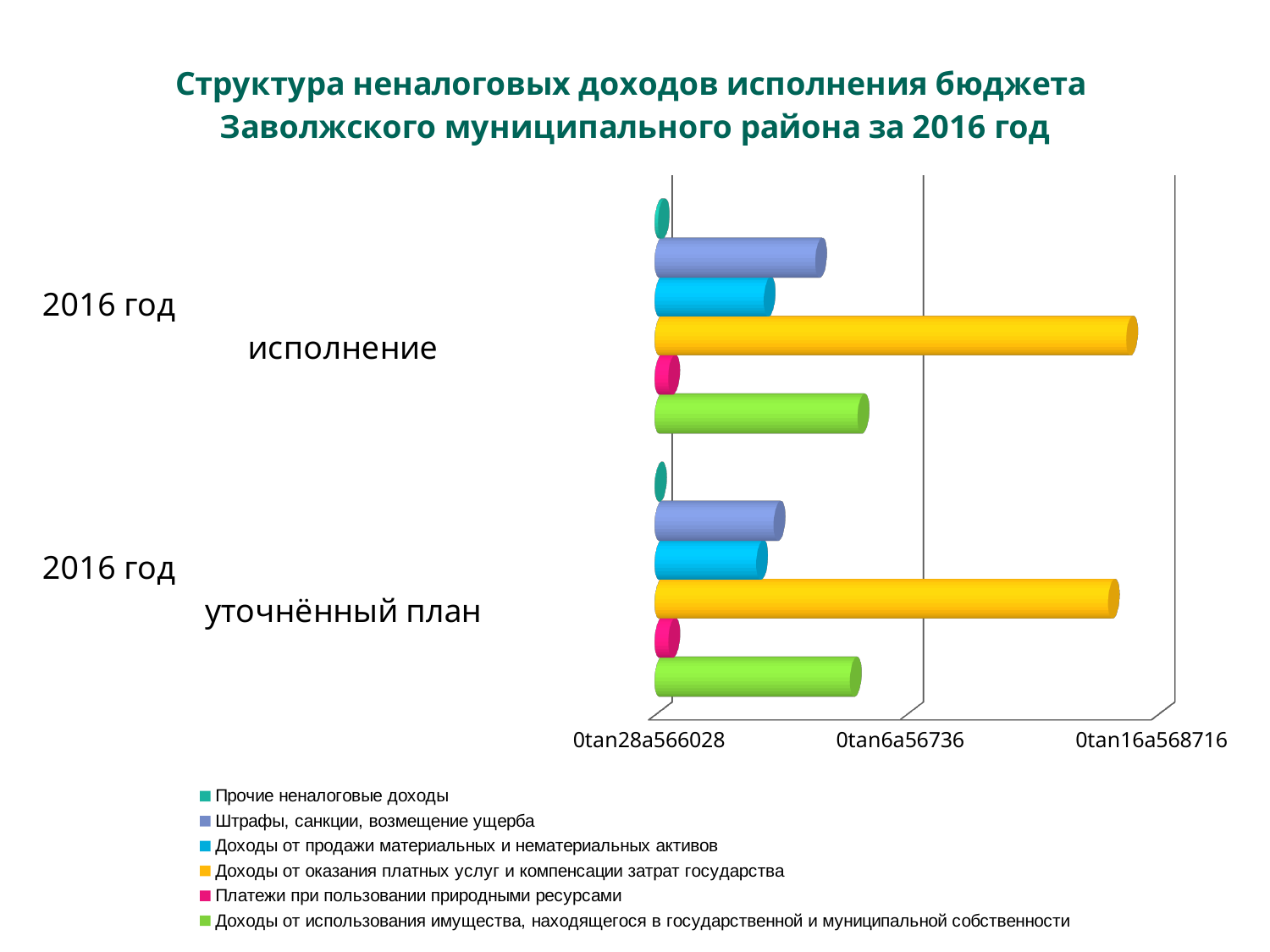
What kind of chart is shown on the slide? bar chart What is the title of the chart? Структура неналоговых доходов исполнения бюджета Заволжского муниципального района за 2016 год How many categories (groups of bars) does the chart show? 2 In the "2016 год уточнённый план" group, which is larger: "Доходы от использования имущества, находящегося в государственной и муниципальной собственности" or "Штрафы, санкции, возмещение ущерба"? Доходы от использования имущества, находящегося в государственной и муниципальной собственности Which colour represents "Платежи при пользовании природными ресурсами" in the legend? pink Which series has the shortest bar in the "2016 год уточнённый план" group? Прочие неналоговые доходы Which series has the longest bar in the "2016 год исполнение" group? Доходы от оказания платных услуг и компенсации затрат государства How many series does the legend list? 6 In the "2016 год исполнение" group, which is larger: "Доходы от использования имущества, находящегося в государственной и муниципальной собственности" or "Платежи при пользовании природными ресурсами"? Доходы от использования имущества, находящегося в государственной и муниципальной собственности Which series has the shortest bar in the "2016 год исполнение" group? Прочие неналоговые доходы Which series has the longest bar in the "2016 год уточнённый план" group? Доходы от оказания платных услуг и компенсации затрат государства In the "2016 год исполнение" group, which is larger: "Штрафы, санкции, возмещение ущерба" or "Доходы от продажи материальных и нематериальных активов"? Штрафы, санкции, возмещение ущерба